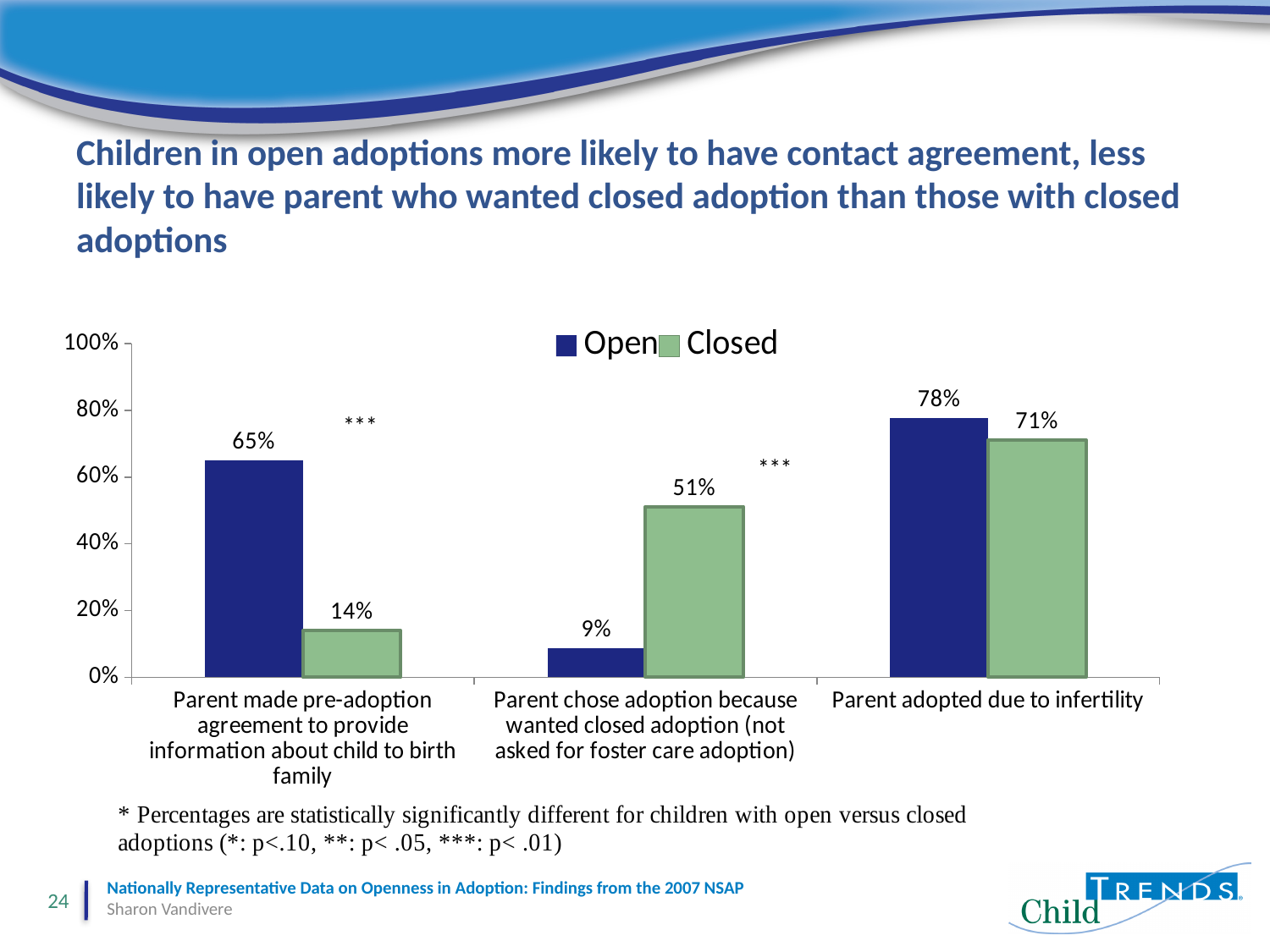
Which category has the highest value for the Open series? Parent adopted due to infertility What is the value for Open for 'Parent made pre-adoption agreement to provide information about child to birth family'? 65% How many categories are shown on the x axis? 3 What kind of chart is shown on the slide? Bar chart What is the value for Closed for 'Parent chose adoption because wanted closed adoption (not asked for foster care adoption)'? 51% For 'Parent adopted due to infertility', which is larger, the Open value or the Closed value? Open What is the difference between the Open and Closed values for 'Parent made pre-adoption agreement to provide information about child to birth family'? 51% Which category has the lowest value for the Closed series? Parent made pre-adoption agreement to provide information about child to birth family What is the value for Open for 'Parent adopted due to infertility'? 78% What is the value for Closed for 'Parent made pre-adoption agreement to provide information about child to birth family'? 14% What is the difference between the Closed and Open values for 'Parent chose adoption because wanted closed adoption (not asked for foster care adoption)'? 42% How many series does the legend list? 2